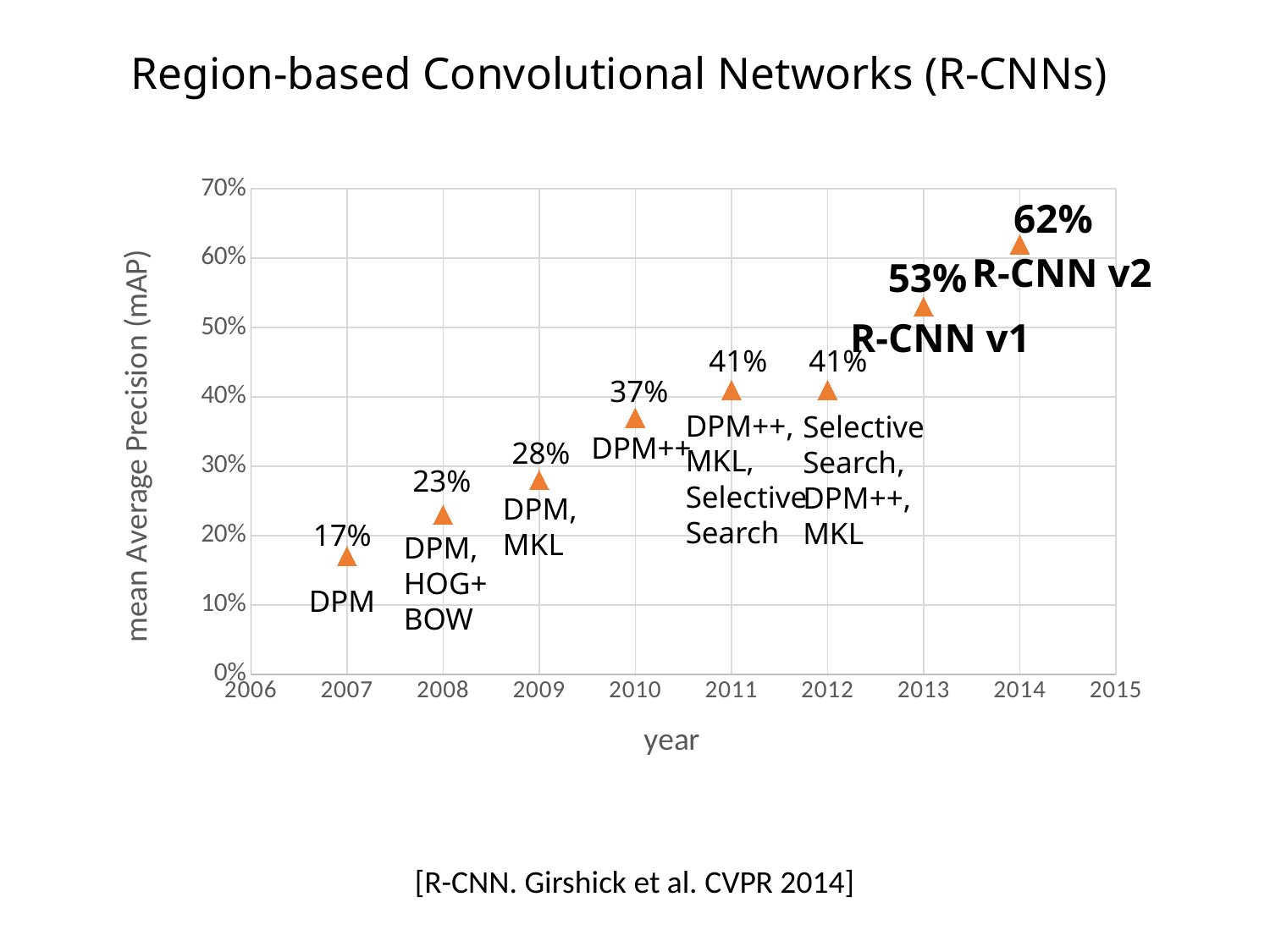
Do the mAP values generally rise or fall as the year increases? rise How many data points are plotted on the chart? 8 Which year has the lowest mAP value? 2007 What is the mAP value plotted for 2014 (R-CNN v2)? 62% What is the mAP value plotted for 2010? 37% Which year has the highest mAP value? 2014 Which has a higher mAP, 2012 or 2013? 2013 What is the difference in mAP between 2014 and 2013? 9% What is the mean Average Precision (mAP) value plotted for 2007? 17% What is the mAP value plotted for 2013 (R-CNN v1)? 53% What is the label of the y axis? mean Average Precision (mAP) What is the difference in mAP between 2009 and 2008? 5%